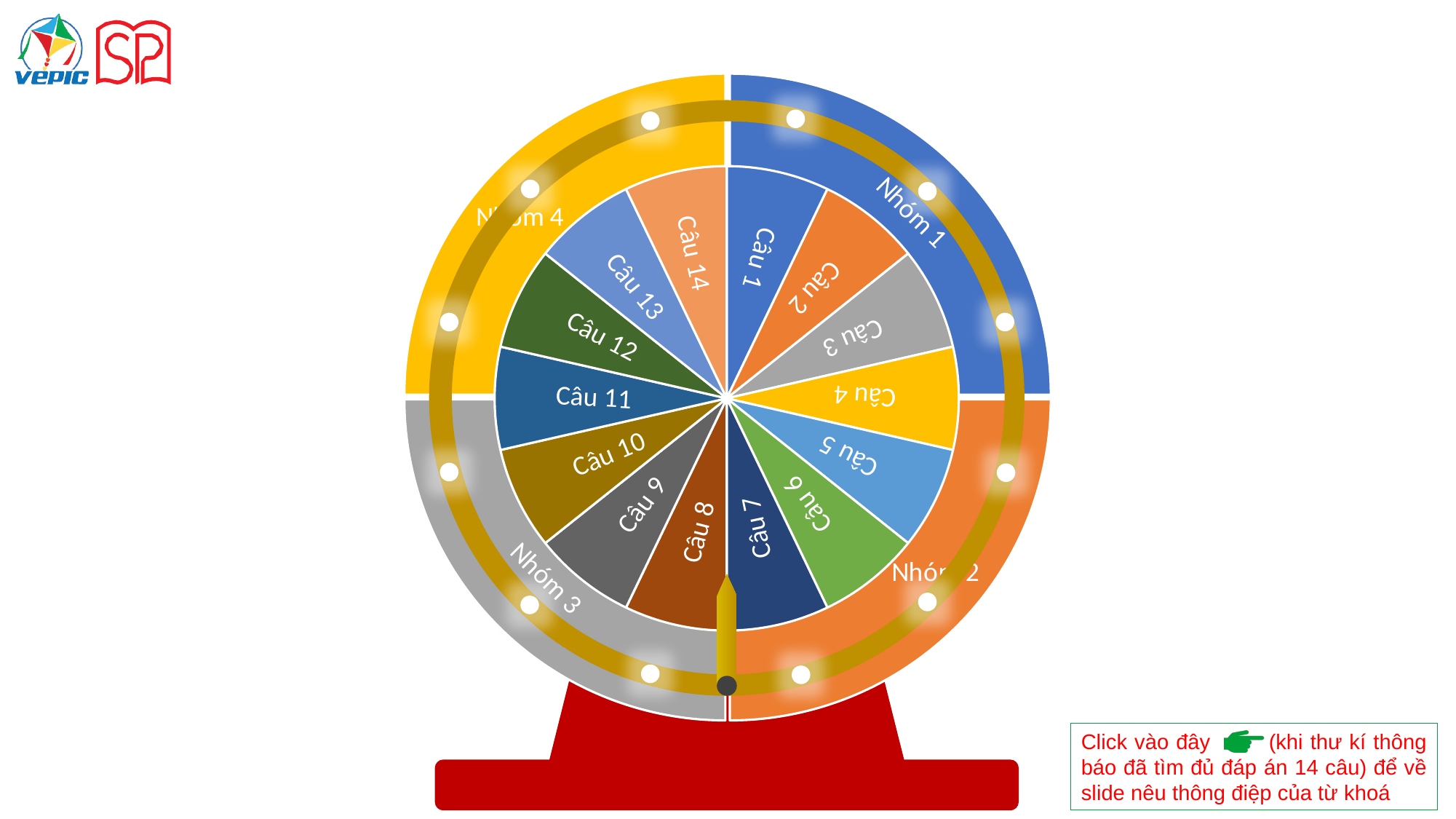
How many groups ('Nhóm') does the outer ring of the wheel show? 4 Which group label appears on the blue section of the outer ring? Nhóm 1 What kind of chart is the outer ring with the 'Nhóm' labels? doughnut chart What kind of chart is the inner wheel with the 'Câu' slices? pie chart How many slices does the inner wheel (the pie of 'Câu' labels) have? 14 Are the slices of the inner wheel all the same size? yes What is the label of the inner slice that lies between Câu 3 and Câu 5? Câu 4